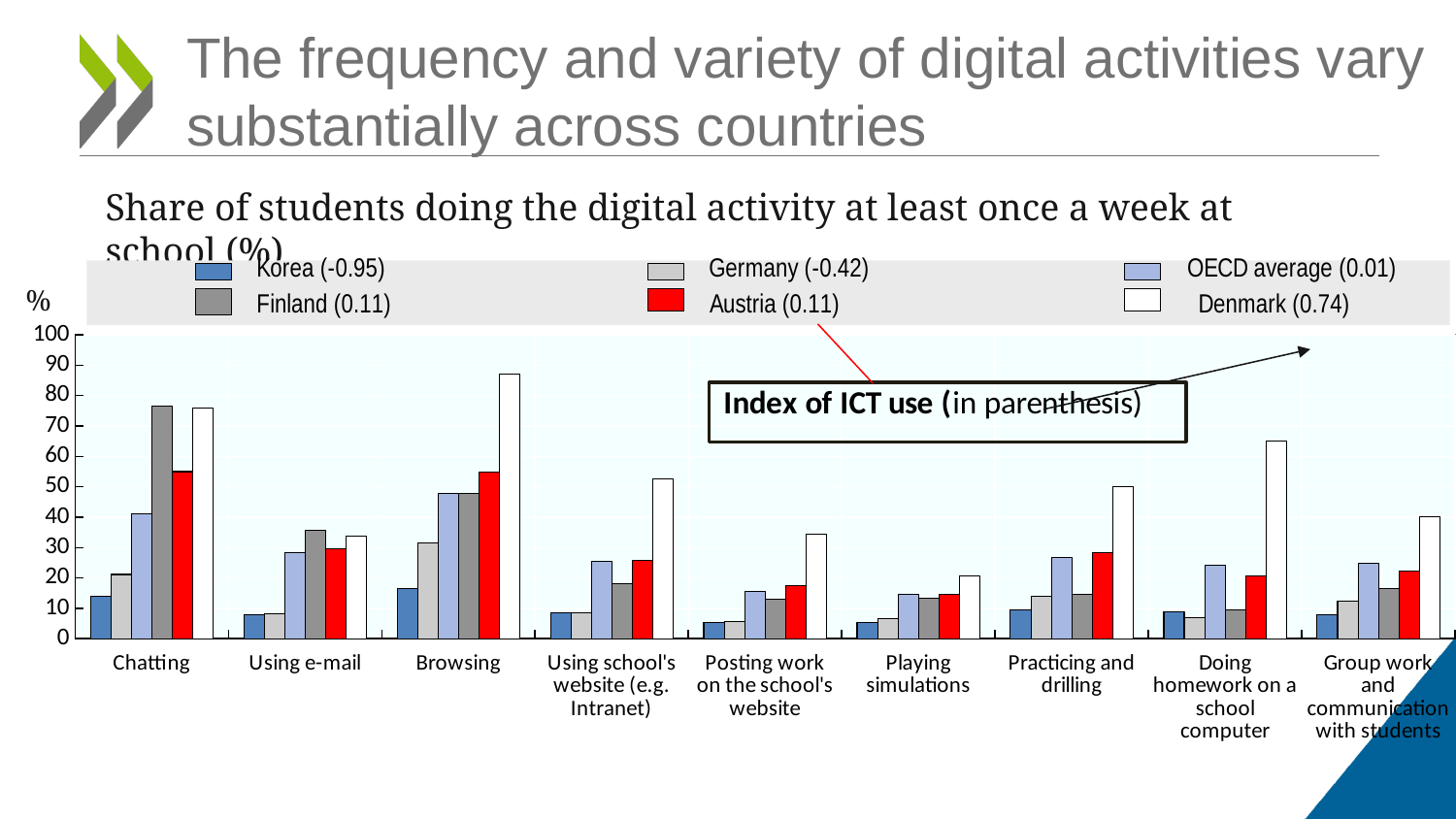
Is the value for Denmark in Doing homework on a school computer greater or less than 60? greater How many series does the legend list? 6 For Chatting, which is larger: the OECD average or Austria? Austria Is the value for Denmark in Browsing greater or less than 80? greater For Browsing, which country or group has the highest share of students? Denmark What index of ICT use is shown in parentheses for Denmark in the legend? 0.74 What kind of chart is shown on the slide? bar chart For Practicing and drilling, which country or group has the lowest share of students? Korea How many digital activities are shown along the x axis? 9 Is the value for Korea in Chatting greater or less than 20? less For Browsing, which is larger: Denmark or Austria? Denmark